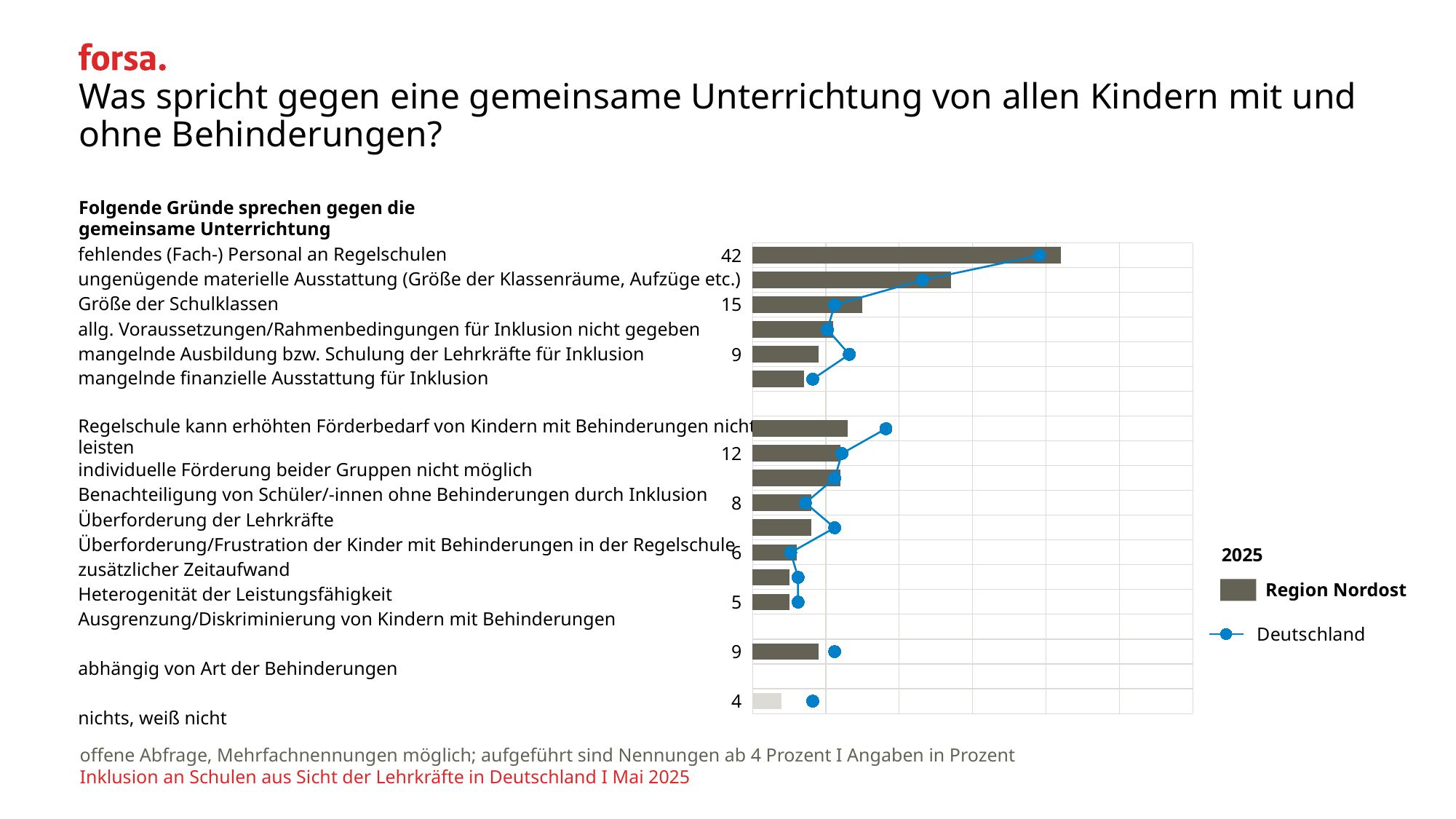
What is the Region Nordost value for "Größe der Schulklassen"? 15 What is the Region Nordost value for "fehlendes (Fach-) Personal an Regelschulen"? 42 Which reason has the highest Region Nordost value? fehlendes (Fach-) Personal an Regelschulen What is the Region Nordost value for "mangelnde Ausbildung bzw. Schulung der Lehrkräfte für Inklusion"? 9 What is the value shown for "nichts, weiß nicht"? 4 For "mangelnde Ausbildung bzw. Schulung der Lehrkräfte für Inklusion", is the Deutschland value higher or lower than the Region Nordost value? higher How many categories (reasons) are listed in the chart? 16 What is the Region Nordost value for "abhängig von Art der Behinderungen"? 9 Which series is shown as a line with dots? Deutschland What kind of chart is used to show the Region Nordost values? bar chart How many series does the legend list? 2 What is the difference between the Region Nordost values for "fehlendes (Fach-) Personal an Regelschulen" and "Größe der Schulklassen"? 27